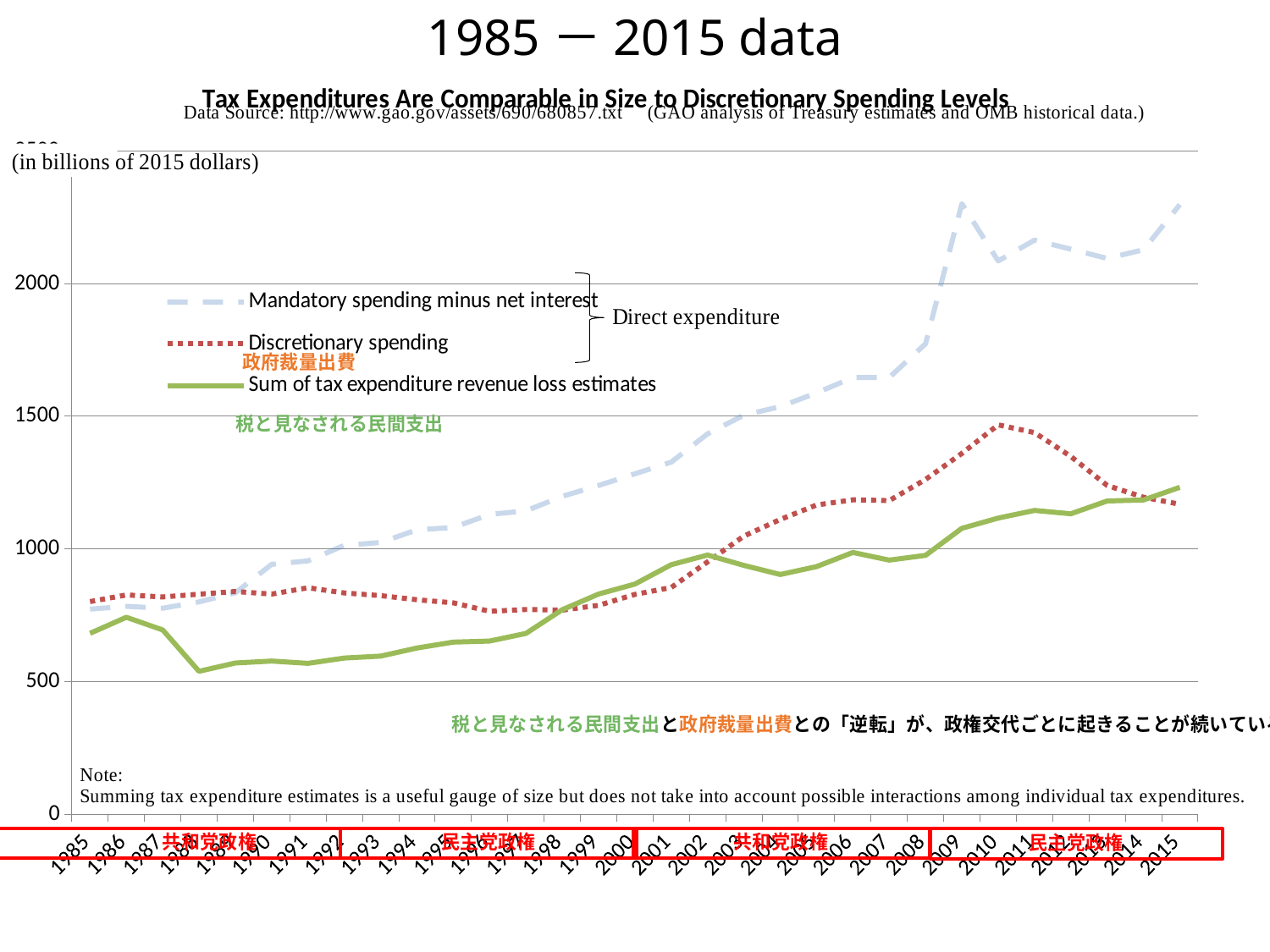
Is the value for Discretionary spending in 2010 greater or less than 1000? greater Is the value for Mandatory spending minus net interest in 1985 greater or less than 1000? less In 2005, which is larger: Discretionary spending or Sum of tax expenditure revenue loss estimates? Discretionary spending How many series does the legend list? 3 In which year does Discretionary spending reach its highest value? 2010 Does Mandatory spending minus net interest rise or fall overall from 1985 to 2015? rise In 1990, which is larger: Discretionary spending or Sum of tax expenditure revenue loss estimates? Discretionary spending Is the value for Sum of tax expenditure revenue loss estimates in 1988 greater or less than 1000? less How many years are plotted along the x axis? 31 Which series has the highest value in 2015? Mandatory spending minus net interest What kind of chart is shown on the slide? line chart